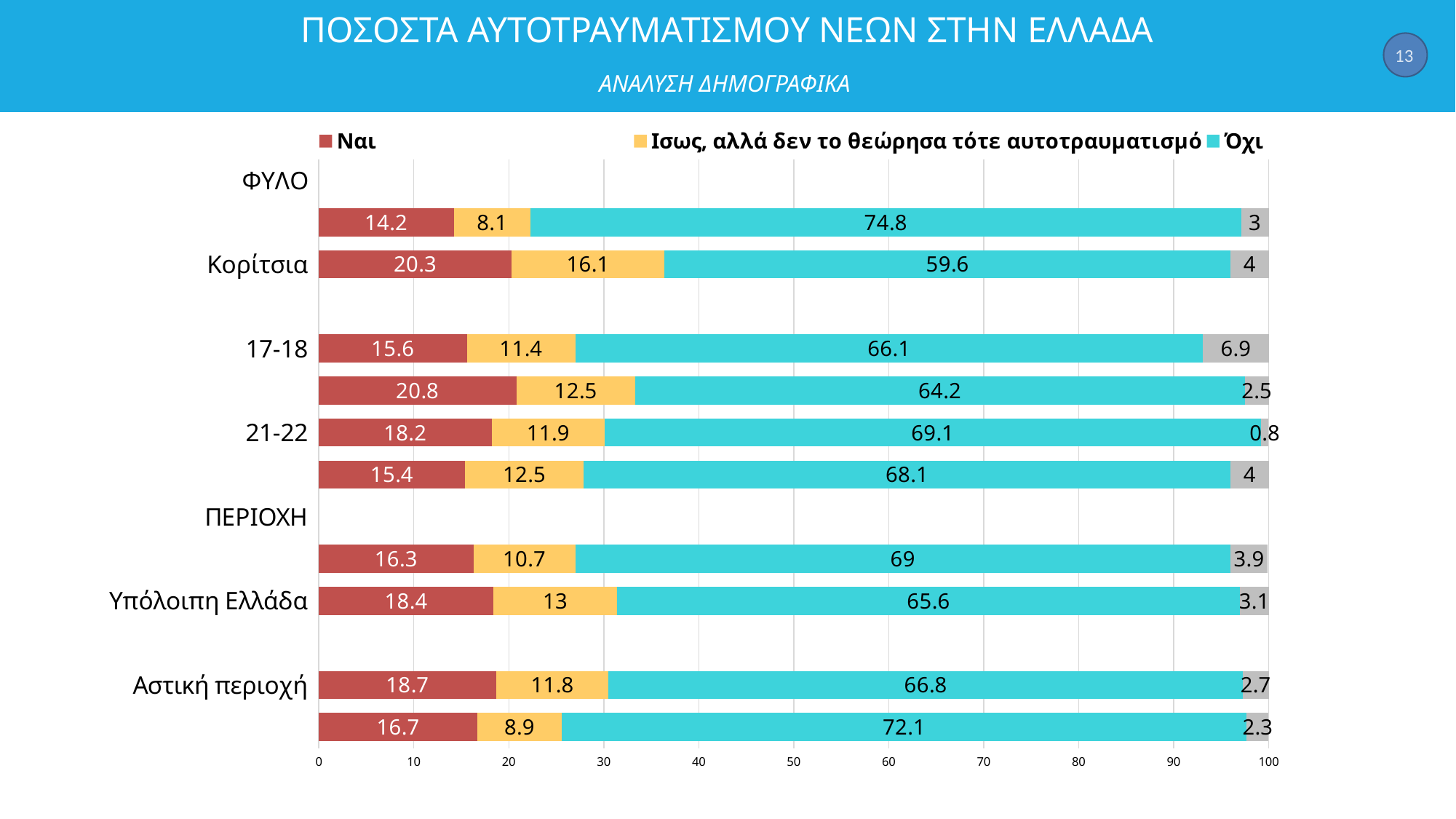
What is the value of the Ναι series for Κορίτσια? 20.3 Among Κορίτσια, 17-18, 21-22, Υπόλοιπη Ελλάδα and Αστική περιοχή, which has the highest Ναι value? Κορίτσια What is the value of the 'Ισως, αλλά δεν το θεώρησα τότε αυτοτραυματισμό' series for Υπόλοιπη Ελλάδα? 13 What is the value of the Όχι series for the 17-18 category? 66.1 What is the value of the Ναι series for Αστική περιοχή? 18.7 How many series does the chart legend list? 3 Which has the larger Ναι value, Κορίτσια or 17-18? Κορίτσια Is the Όχι value for Κορίτσια greater or less than 60? less What kind of chart is shown on the slide? Stacked horizontal bar chart What is the value of the Όχι series for the 21-22 category? 69.1 What is the title of the slide containing the chart? ΠΟΣΟΣΤΑ ΑΥΤΟΤΡΑΥΜΑΤΙΣΜΟΥ ΝΕΩΝ ΣΤΗΝ ΕΛΛΑΔΑ What is the difference between the Όχι values for 21-22 and Κορίτσια? 9.5